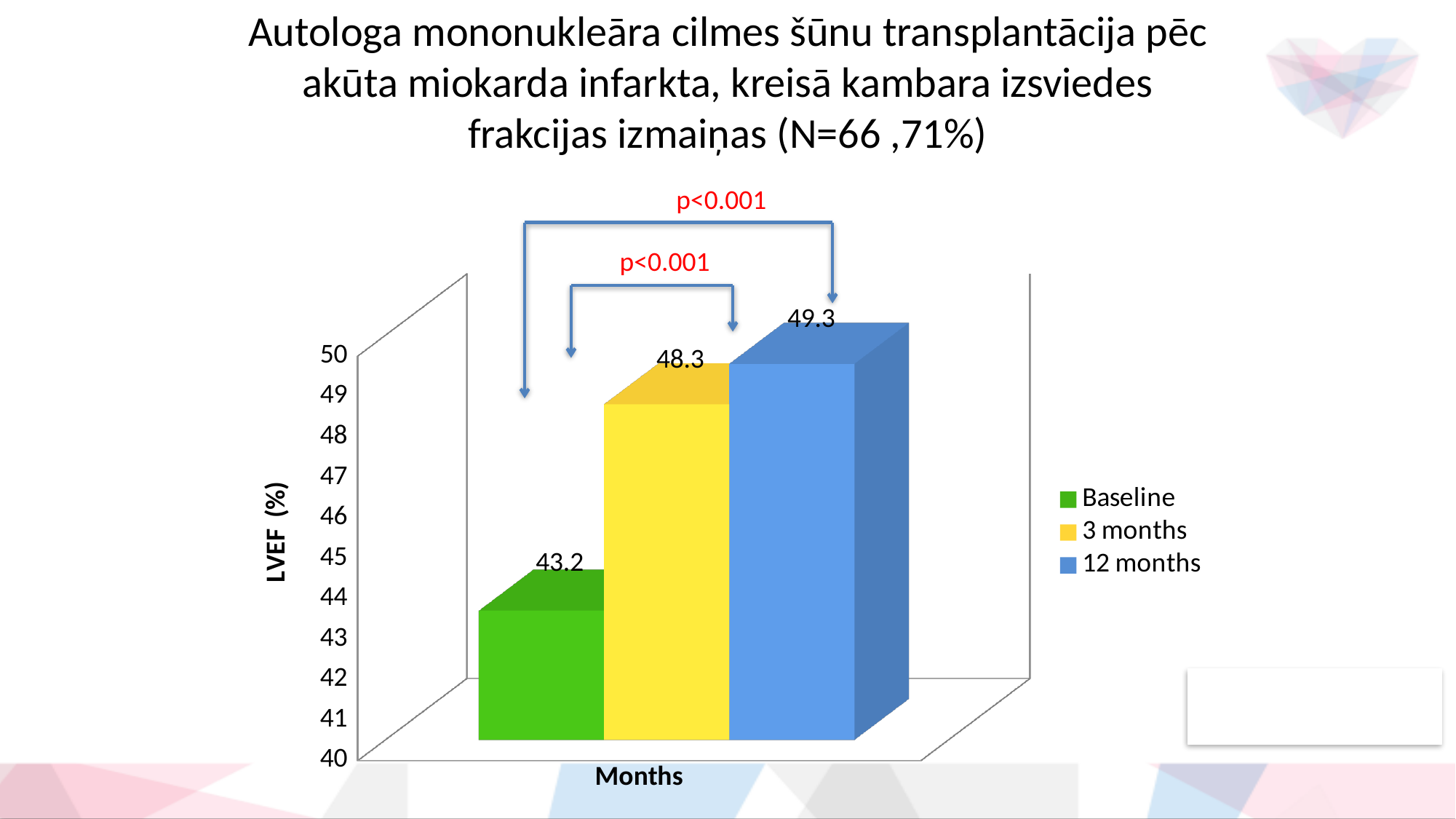
What is the difference between the 3 months and Baseline LVEF values? 5.1 What is the difference between the 12 months and Baseline LVEF values? 6.1 How many series does the legend list? 3 What is the label of the vertical axis? LVEF (%) What kind of chart is shown on the slide? bar chart Which series has the highest LVEF value? 12 months What is the LVEF value for Baseline? 43.2 What is the LVEF value at 3 months? 48.3 What is the LVEF value at 12 months? 49.3 Which series has the lowest LVEF value? Baseline Is the Baseline LVEF value greater or less than 45? less Which is larger, the LVEF value at 3 months or at Baseline? 3 months